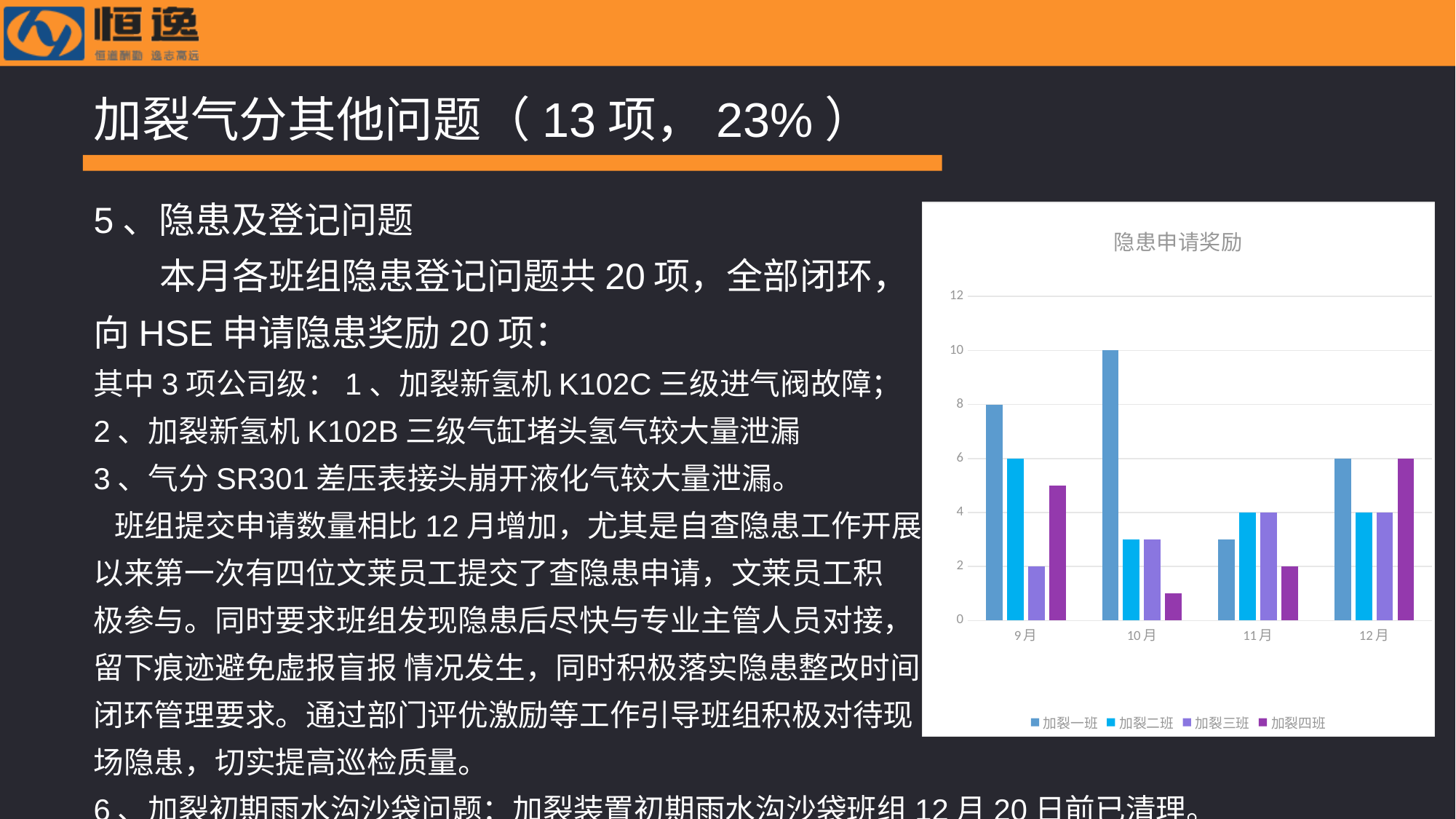
Which series has the lowest bar in 10月? 加裂四班 What is the value for 加裂四班 in 12月? 6 What is the value for 加裂三班 in 9月? 2 Is the value for 加裂四班 in 9月 greater or less than 4? greater What is the title of the chart? 隐患申请奖励 How many series does the chart legend list? 4 What is the difference between 加裂一班 and 加裂三班 in 9月? 6 What is the value for 加裂一班 in 10月? 10 What is the value for 加裂一班 in 9月? 8 Which series has the highest bar in 10月? 加裂一班 What kind of chart is shown on the slide? bar chart How many month categories are shown on the x axis of the chart? 4